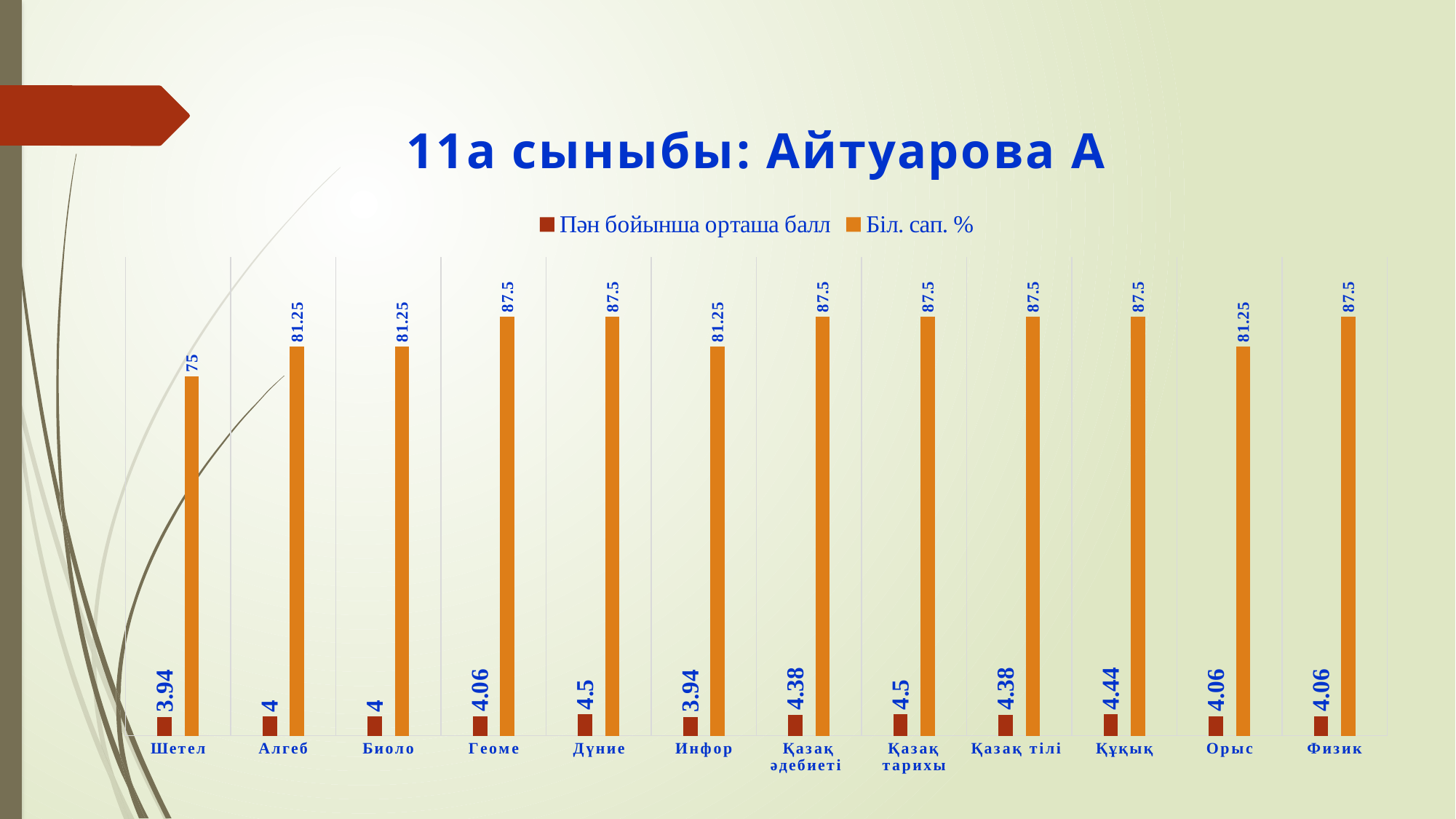
Which category has the lowest Біл. сап. % value? Шетел What is the Пән бойынша орташа балл value for Құқық? 4.44 What is the difference between the Пән бойынша орташа балл values for Дүние and Инфор? 0.56 What is the Біл. сап. % value for Орыс? 81.25 How many series does the legend list? 2 How many categories are shown on the x axis of the chart? 12 What is the Пән бойынша орташа балл value for Қазақ тарихы? 4.5 Which has a higher Пән бойынша орташа балл value, Қазақ тілі or Биоло? Қазақ тілі What is the value of Біл. сап. % for Шетел? 75 Which has a higher Біл. сап. % value, Алгеб or Физик? Физик What is the difference between the Біл. сап. % values for Геоме and Шетел? 12.5 What type of chart is shown on the slide? Bar chart